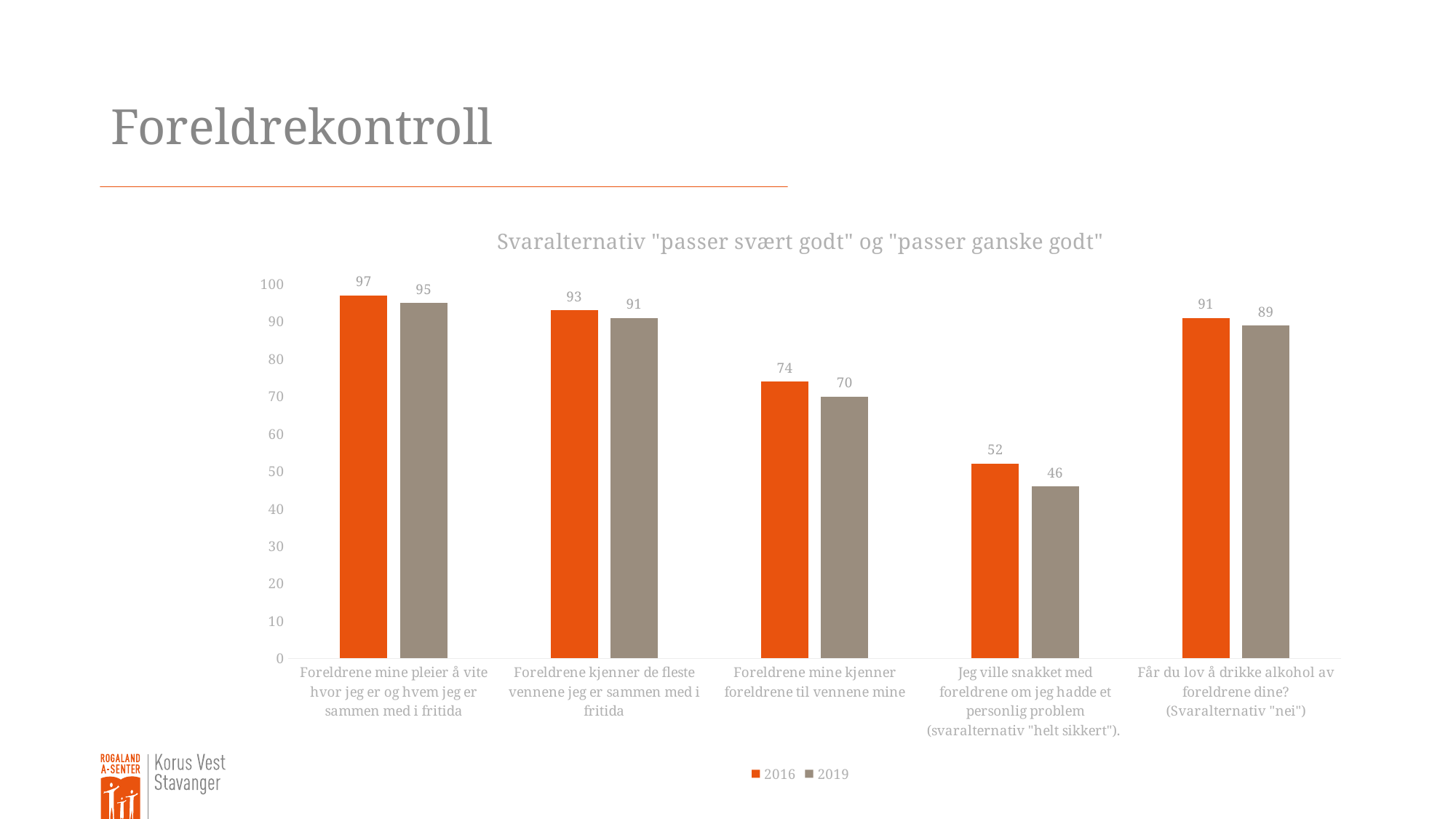
What is the 2019 value for "Foreldrene mine kjenner foreldrene til vennene mine"? 70 How many categories are shown on the x axis? 5 What is the difference between the 2016 and 2019 values for "Jeg ville snakket med foreldrene om jeg hadde et personlig problem"? 6 How many series does the legend list? 2 What is the 2016 value for "Foreldrene mine pleier å vite hvor jeg er og hvem jeg er sammen med i fritida"? 97 What kind of chart is shown on the slide? Bar chart What is the 2019 value for "Jeg ville snakket med foreldrene om jeg hadde et personlig problem (svaralternativ "helt sikkert")"? 46 Which category has the lowest 2016 value? Jeg ville snakket med foreldrene om jeg hadde et personlig problem (svaralternativ "helt sikkert"). Which category has the highest 2019 value? Foreldrene mine pleier å vite hvor jeg er og hvem jeg er sammen med i fritida What is the title of the chart? Svaralternativ "passer svært godt" og "passer ganske godt" What is the difference between the 2016 and 2019 values for "Foreldrene kjenner de fleste vennene jeg er sammen med i fritida"? 2 Which is larger for "Får du lov å drikke alkohol av foreldrene dine?": the 2016 value or the 2019 value? 2016